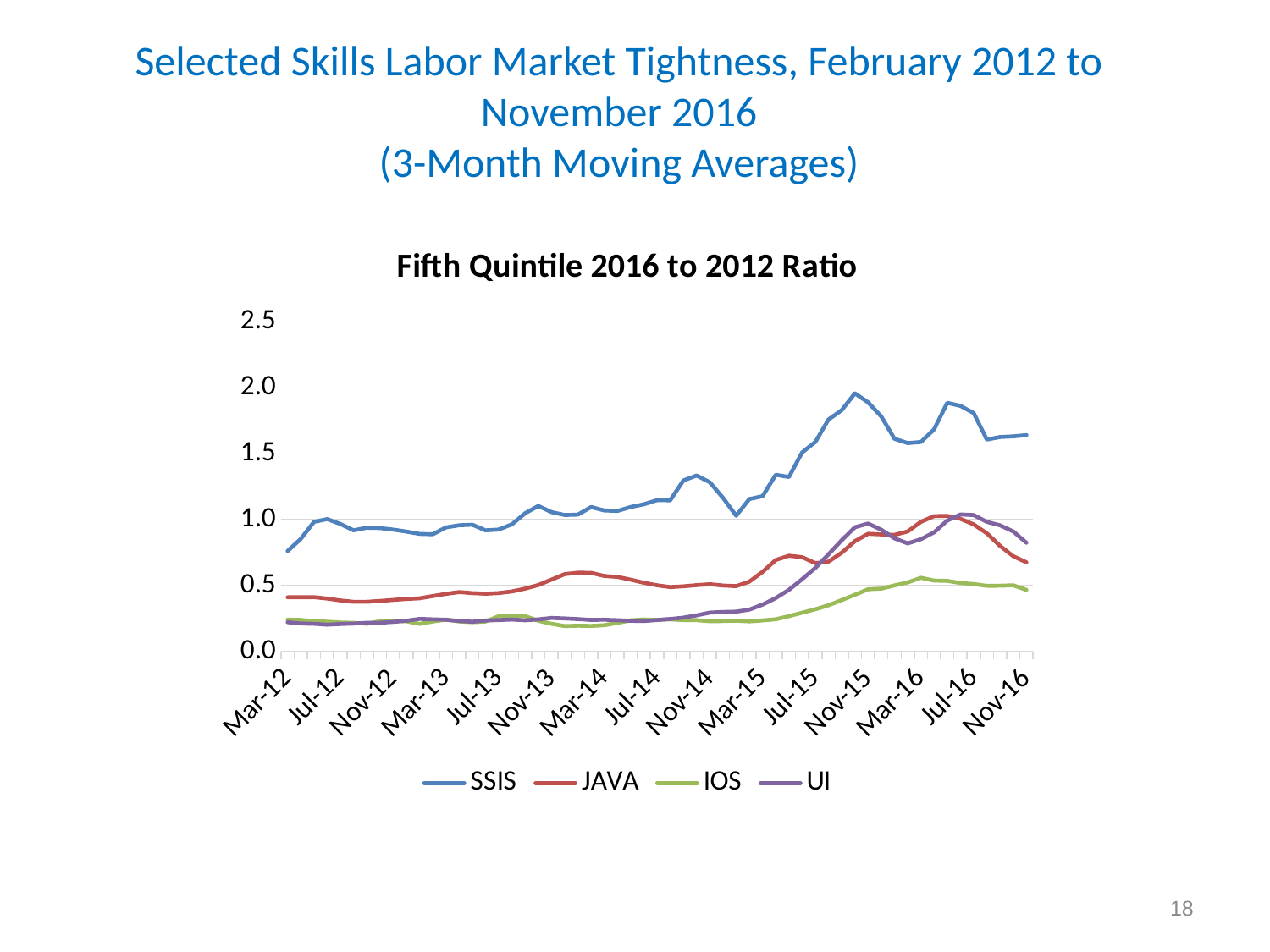
Does the SSIS series generally rise or fall from Mar-12 to Nov-16? rise Is the value for UI at Mar-14 greater or less than 0.5? less What kind of chart is shown on the slide? line chart What is the title of the chart? Fifth Quintile 2016 to 2012 Ratio Which series has the highest values across the chart? SSIS Which series are listed in the legend? SSIS, JAVA, IOS, UI At Nov-16, which series has the larger value, UI or IOS? UI Is the value for SSIS at Nov-15 greater or less than 1.5? greater How many series does the legend list? 4 Is the value for SSIS at Mar-12 greater or less than 1.0? less Which series has the lowest value at Nov-16? IOS